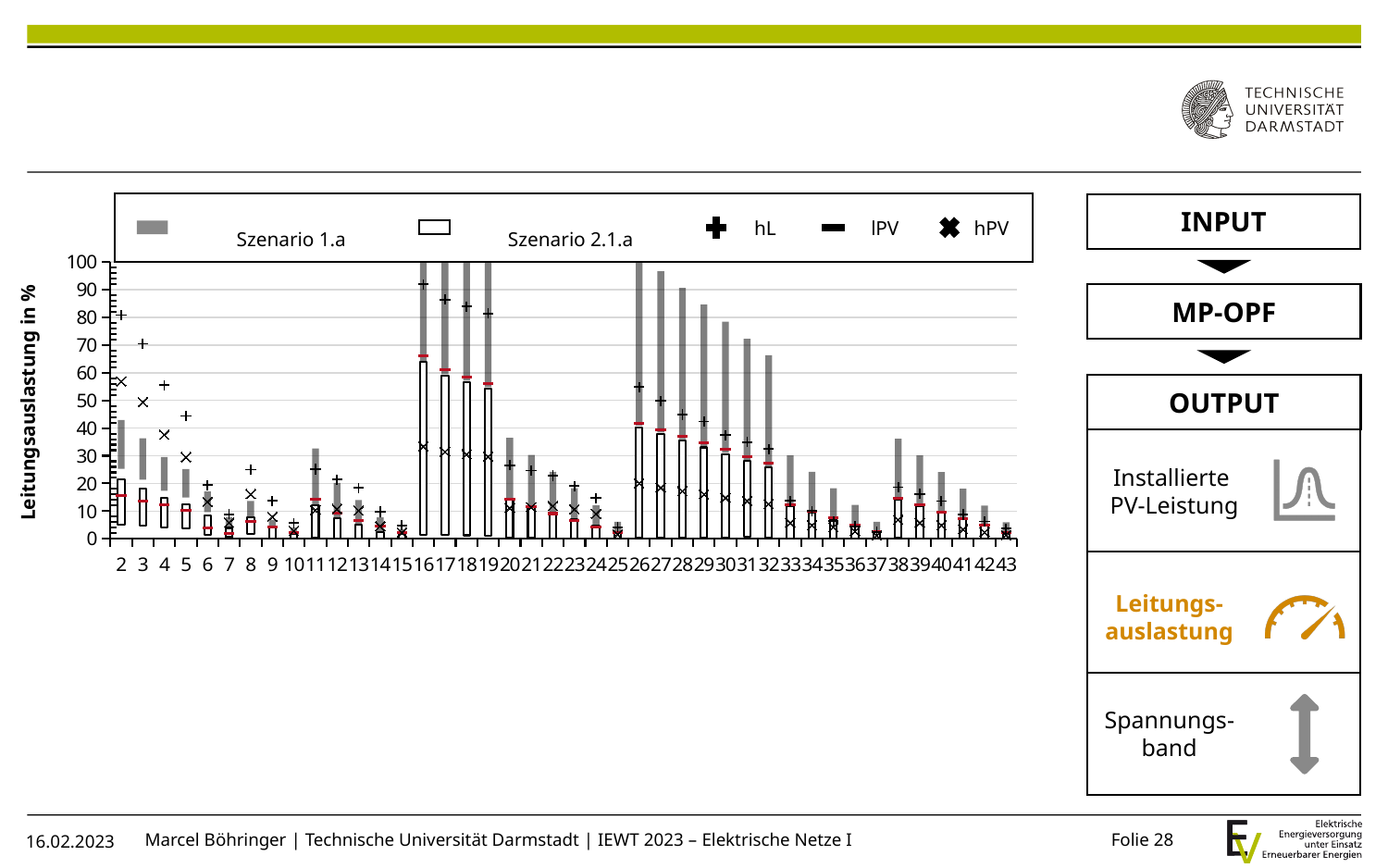
Is the Szenario 2.1.a value for category 16 greater or less than 50? greater What is the label of the y axis of the chart? Leitungsauslastung in % Is the Szenario 1.a value for category 2 greater or less than 50? less What is the highest value shown on the y axis of the chart? 100 Is the Szenario 1.a value for category 37 greater or less than 10? less How many categories are shown along the x axis of the chart? 42 Which has the larger Szenario 1.a value, category 26 or category 32? 26 What kind of chart is shown on the slide? bar chart Which has the larger Szenario 1.a value, category 16 or category 2? 16 How many entries does the chart legend list? 5